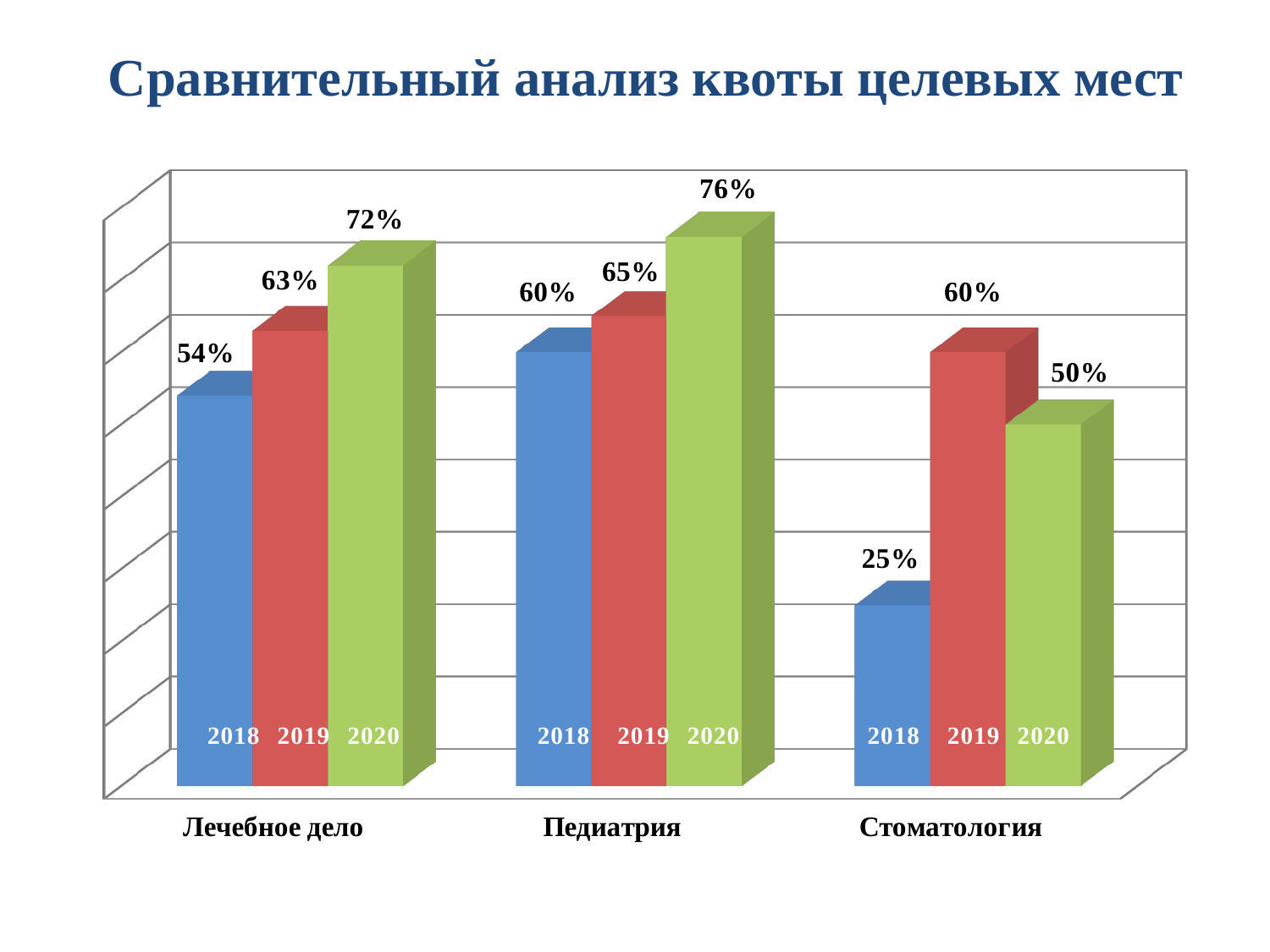
Which is larger for Педиатрия: the 2018 value or the 2019 value? 2019 How many years (series) are shown for each category? 3 Which category has the lowest value in 2018? Стоматология How many categories are shown on the x axis? 3 What kind of chart is shown on the slide? Bar chart What is the value for Стоматология in 2018? 25% What is the difference between the 2019 and 2020 values for Стоматология? 10% What is the value for Педиатрия in 2020? 76% What is the difference between the 2020 and 2018 values for Лечебное дело? 18% Which category has the highest value in 2020? Педиатрия What is the title of the chart on the slide? Сравнительный анализ квоты целевых мест What is the value for Лечебное дело in 2019? 63%